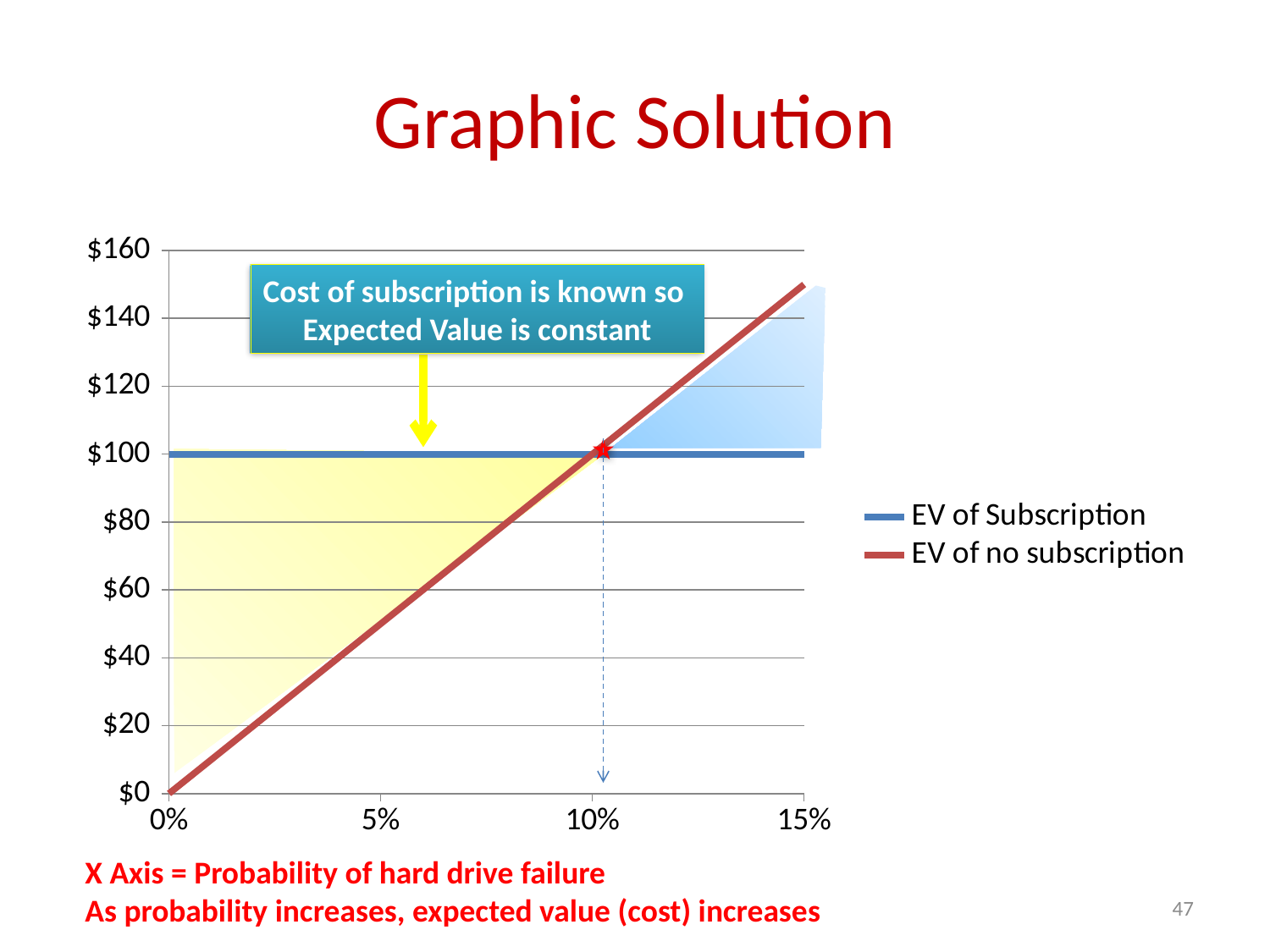
Does the EV of no subscription line rise or fall as the probability increases along the x axis? rises What kind of chart is shown on the slide? line chart According to the slide, what does the x axis represent? Probability of hard drive failure What is the value of EV of no subscription at 0%? $0 Is the value for EV of no subscription at 15% greater or less than $140? greater At what probability do the EV of Subscription and EV of no subscription lines cross? 10% How many series does the legend list? 2 At 5%, which series has the larger value, EV of Subscription or EV of no subscription? EV of Subscription Does the EV of Subscription line rise, fall, or stay constant along the x axis? stays constant What is the value of the EV of Subscription line? $100 At 15%, which series has the larger value, EV of Subscription or EV of no subscription? EV of no subscription Is the value for EV of no subscription at 5% greater or less than $60? less